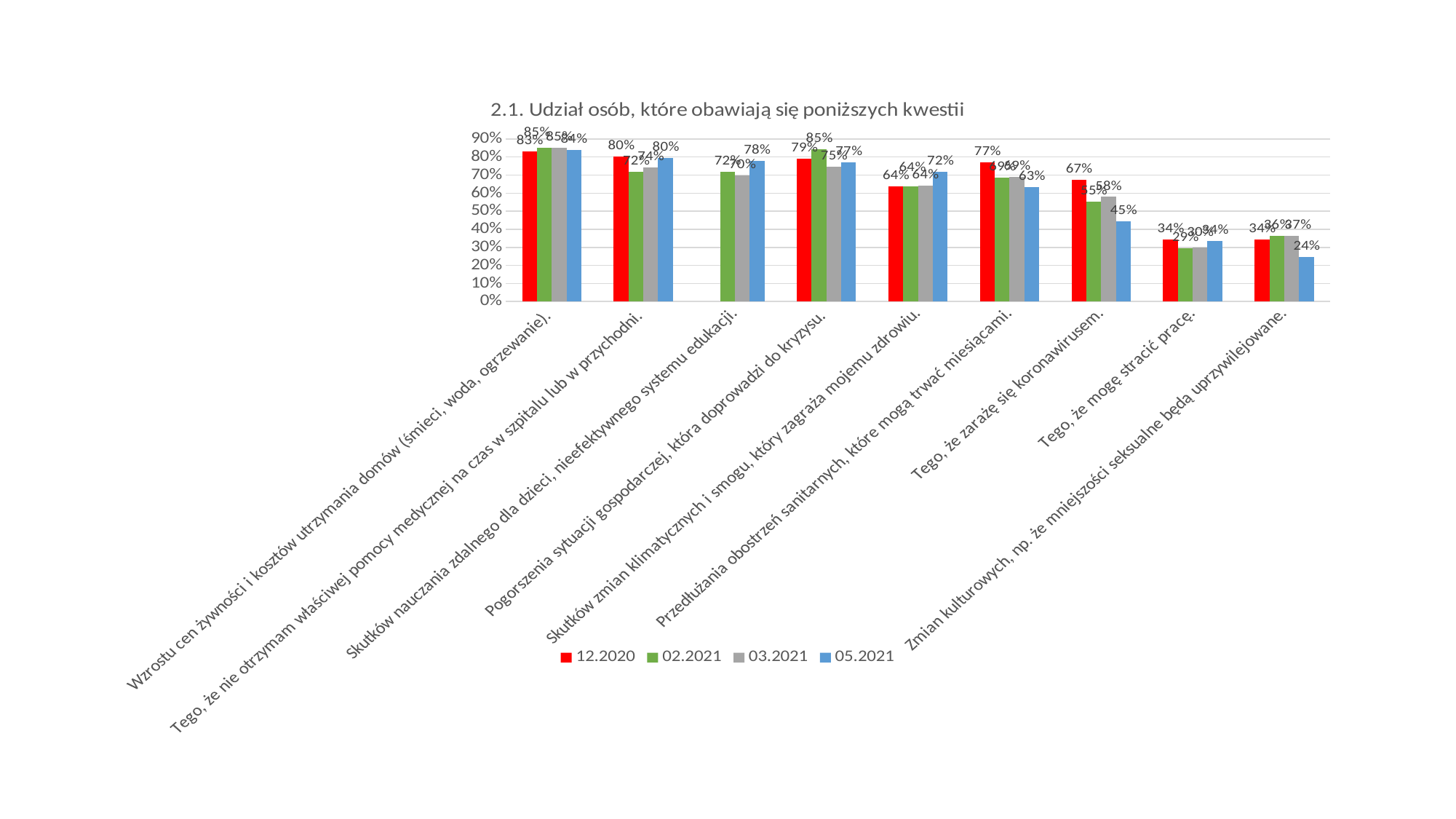
Is the 03.2021 value for "Tego, że mogę stracić pracę." greater or less than 40%? less How many categories are shown on the x axis? 9 In the category "Pogorszenia sytuacji gospodarczej, która doprowadzi do kryzysu.", which series has the larger value: 12.2020 or 02.2021? 02.2021 In the category "Tego, że zarażę się koronawirusem.", by how many percentage points does the 12.2020 value exceed the 05.2021 value? 22 percentage points How many series does the legend list? 4 What is the value for 12.2020 in the category "Przedłużania obostrzeń sanitarnych, które mogą trwać miesiącami."? 77% What is the value for 05.2021 in the category "Skutków nauczania zdalnego dla dzieci, nieefektywnego systemu edukacji."? 78% What kind of chart is shown on the slide? bar chart What is the value for 05.2021 in the category "Tego, że zarażę się koronawirusem."? 45% For the 12.2020 series, which category has the highest value? Wzrostu cen żywności i kosztów utrzymania domów (śmieci, woda, ogrzewanie). For the 05.2021 series, which category has the lowest value? Zmian kulturowych, np. że mniejszości seksualne będą uprzywilejowane. Which category has no bar for the 12.2020 series? Skutków nauczania zdalnego dla dzieci, nieefektywnego systemu edukacji.